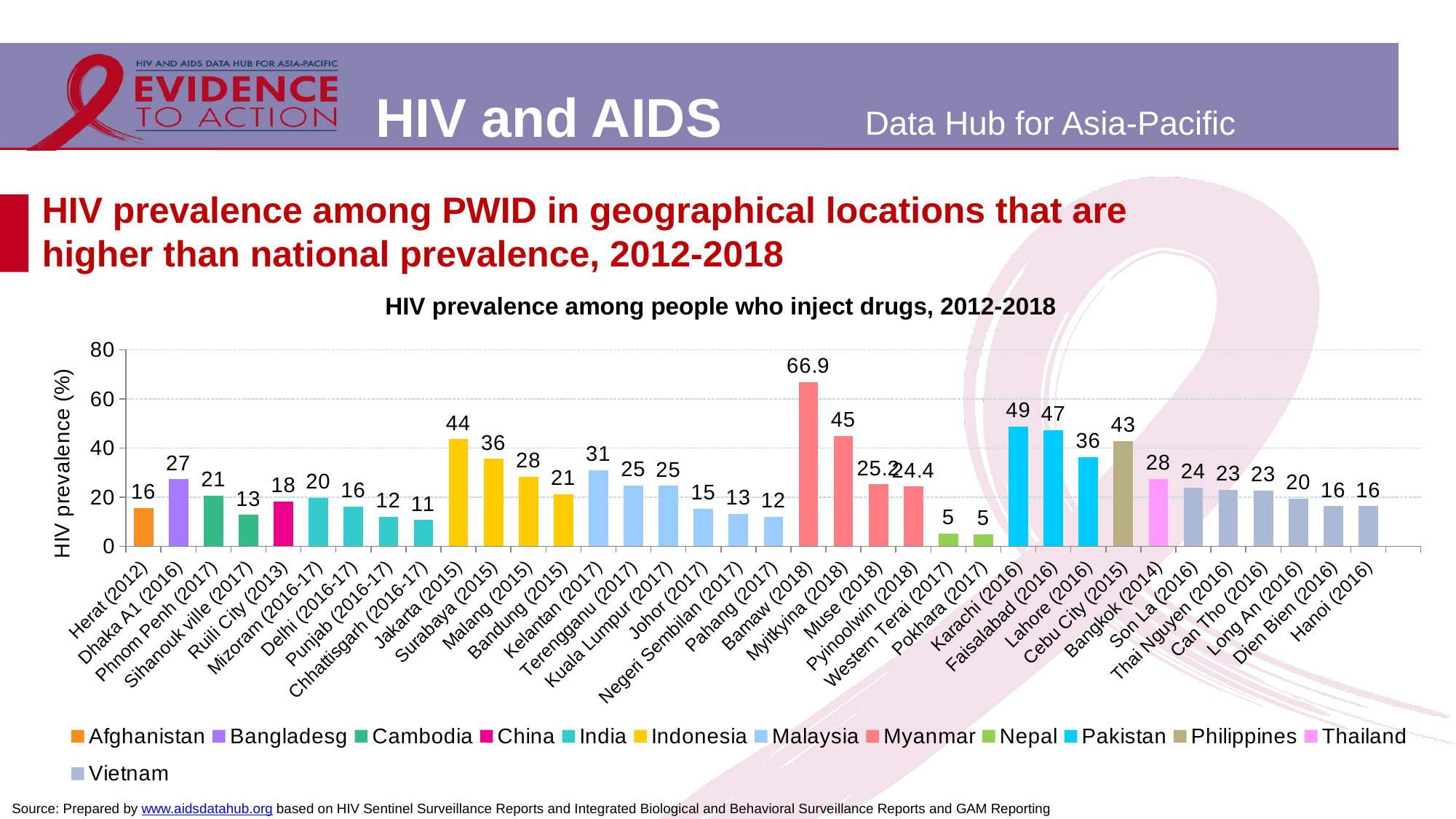
Which location has the highest HIV prevalence in the chart? Bamaw (2018) Which has a higher value, Jakarta (2015) or Surabaya (2015)? Jakarta (2015) What is the title of the chart? HIV prevalence among people who inject drugs, 2012-2018 Is the value for Lahore (2016) greater or less than 20? greater What is the difference between the values for Karachi (2016) and Faisalabad (2016)? 2 What is the HIV prevalence value shown for Karachi (2016)? 49 How many locations are plotted on the x axis of the chart? 36 What is the HIV prevalence value shown for Bamaw (2018)? 66.9 How many countries does the legend list? 13 What kind of chart is shown on the slide? Bar chart What is the difference between the values for Bamaw (2018) and Myitkyina (2018)? 21.9 What is the HIV prevalence value shown for Cebu City (2015)? 43